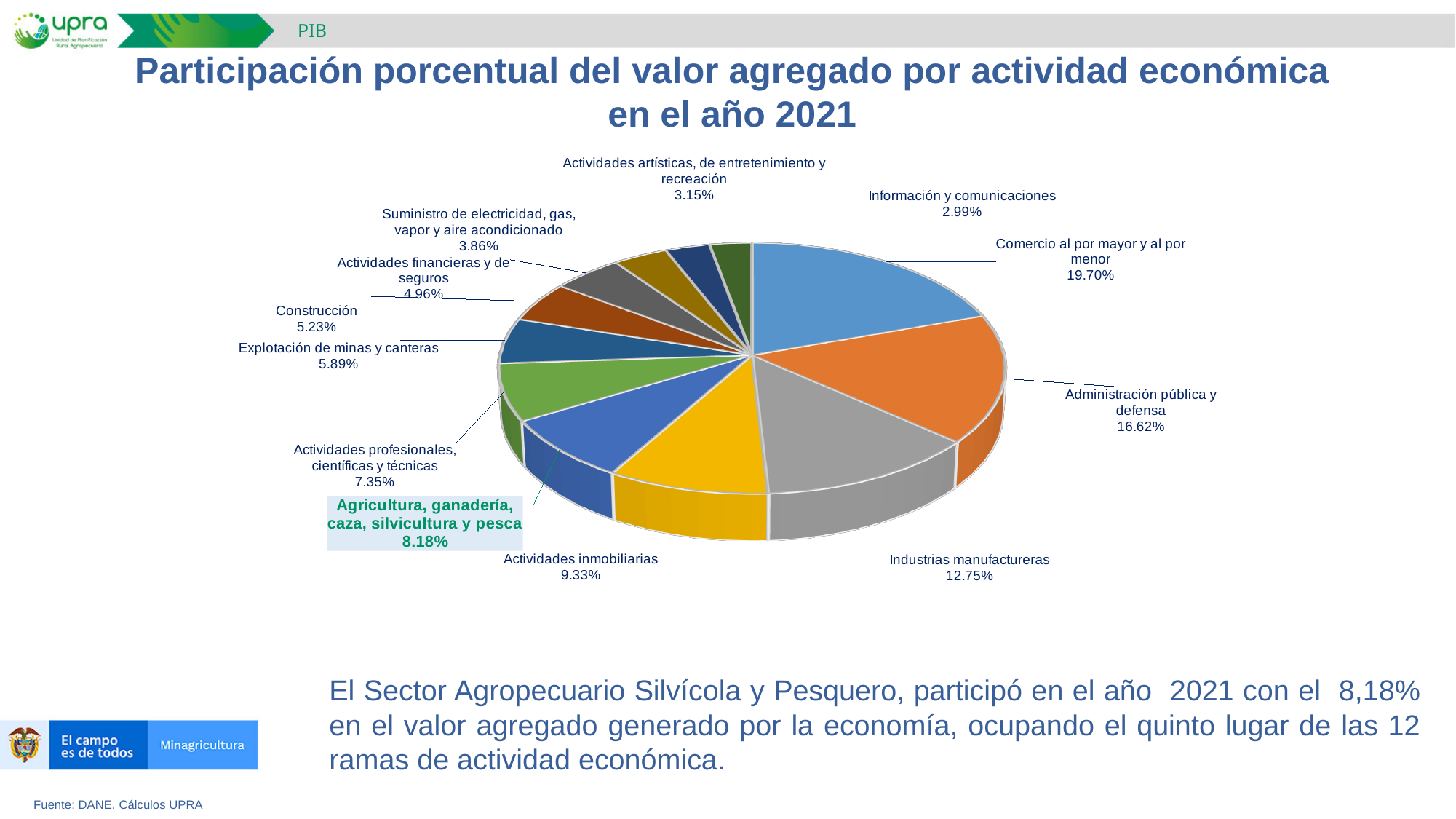
Which economic activity has the smallest share in the pie chart? Información y comunicaciones What is the difference between Industrias manufactureras and Actividades inmobiliarias? 3.42 percentage points Which has a larger share: Actividades inmobiliarias or Actividades profesionales, científicas y técnicas? Actividades inmobiliarias What kind of chart is shown on the slide? Pie chart Which economic activity has the largest share in the pie chart? Comercio al por mayor y al por menor How many slices (economic activities) does the pie chart contain? 12 What is the difference in percentage points between Comercio al por mayor y al por menor and Administración pública y defensa? 3.08 percentage points What percentage does Agricultura, ganadería, caza, silvicultura y pesca represent in the chart? 8.18% What share is shown for Información y comunicaciones? 2.99% What is the title of the chart on the slide? Participación porcentual del valor agregado por actividad económica en el año 2021 What is the value shown for Industrias manufactureras? 12.75% What is the share of Comercio al por mayor y al por menor in the pie chart? 19.70%